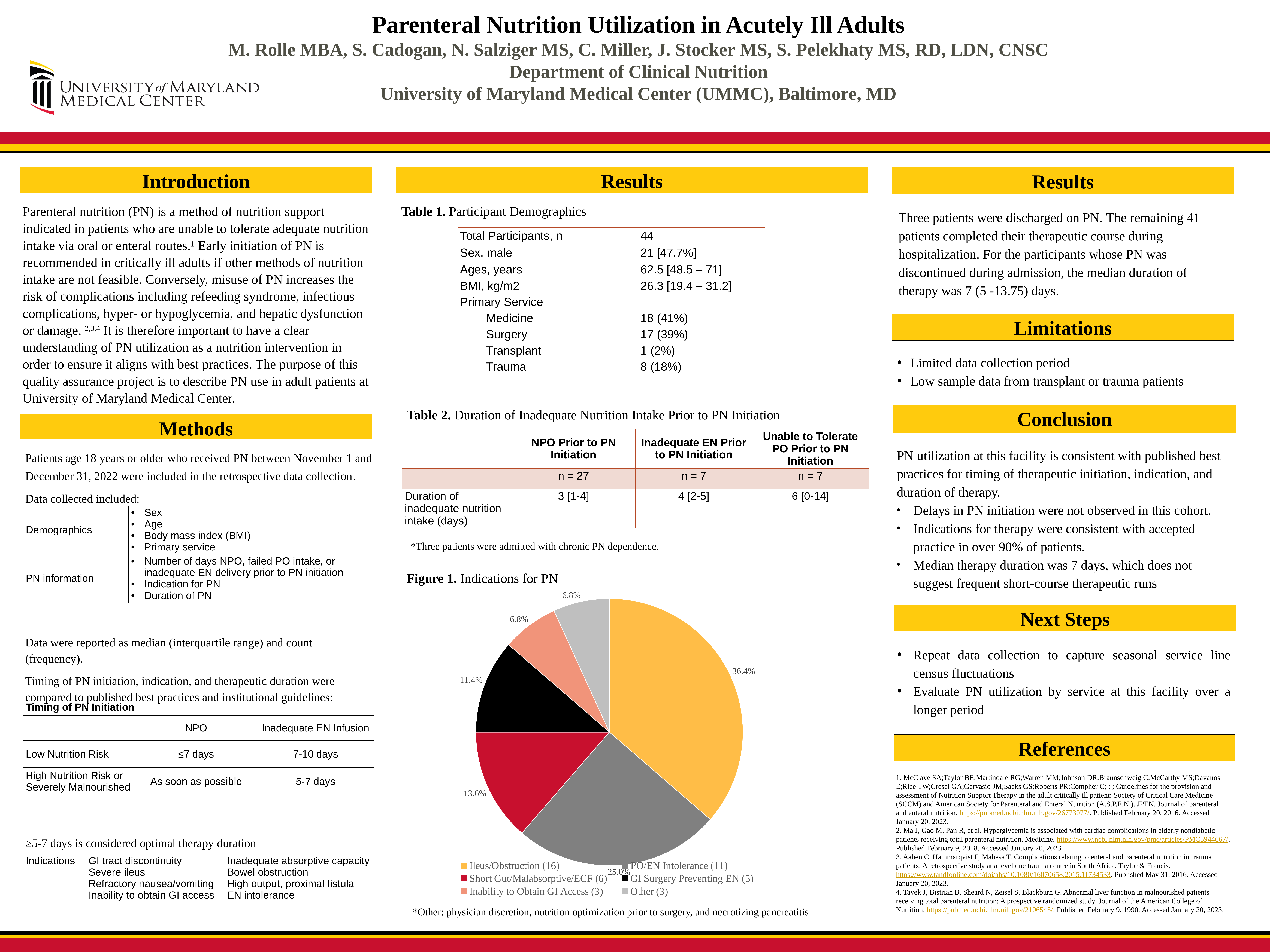
In Figure 1, what is the difference in percentage points between the Ileus/Obstruction slice and the PO/EN Intolerance slice? 11.4% In Figure 1, how many patients had Ileus/Obstruction as the indication for PN, according to the legend? 16 What percentage of the Figure 1 pie chart is Short Gut/Malabsorptive/ECF? 13.6% What percentage of the Figure 1 pie chart is GI Surgery Preventing EN? 11.4% In Figure 1, which slice is larger: Short Gut/Malabsorptive/ECF or GI Surgery Preventing EN? Short Gut/Malabsorptive/ECF What kind of chart is Figure 1, Indications for PN? pie chart What percentage of the Figure 1 pie chart is PO/EN Intolerance? 25.0% Which indication has the largest share in the Figure 1 pie chart? Ileus/Obstruction How many slices does the pie chart in Figure 1 have? 6 What is the title of the pie chart on the slide? Figure 1. Indications for PN